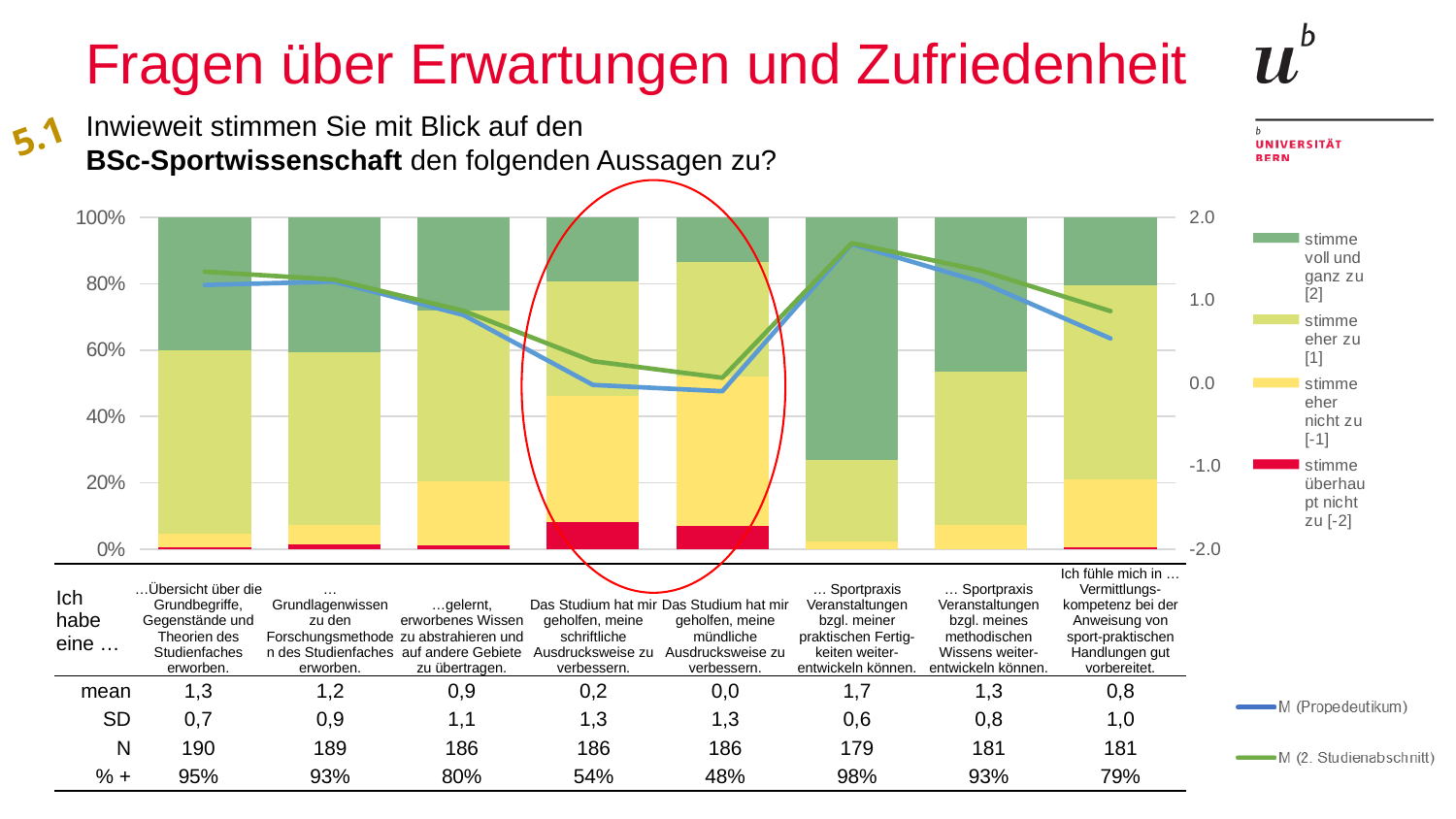
What is the SD for the statement about Grundlagenwissen zu den Forschungsmethoden des Studienfaches? 0,9 How many agreement levels does the legend on the right of the chart list for the stacked bars? 4 Which statement has the lowest % + value? Das Studium hat mir geholfen, meine mündliche Ausdrucksweise zu verbessern. Which statement has the highest mean value? … Sportpraxis Veranstaltungen bzgl. meiner praktischen Fertigkeiten weiterentwickeln können. How many statements (stacked bars) are shown in the chart? 8 What kind of chart is used to show the agreement levels for each statement? Stacked bar chart (with overlaid lines) What is the difference in % + between the statement about Übersicht über die Grundbegriffe (95%) and the statement about mündliche Ausdrucksweise (48%)? 47 percentage points What is the % + value for the statement about improving one's schriftliche Ausdrucksweise (written expression)? 54% What is the mean value for the statement about improving one's mündliche Ausdrucksweise (oral expression)? 0,0 What is the N for the statement about Sportpraxis Veranstaltungen bzgl. praktischer Fertigkeiten? 179 Which two groups are represented by the lines overlaid on the bars? M (Propedeutikum) and M (2. Studienabschnitt) Which has a larger mean: the statement about Vermittlungskompetenz (0,8) or the statement about abstrahieren und auf andere Gebiete übertragen (0,9)? …gelernt, erworbenes Wissen zu abstrahieren und auf andere Gebiete zu übertragen.